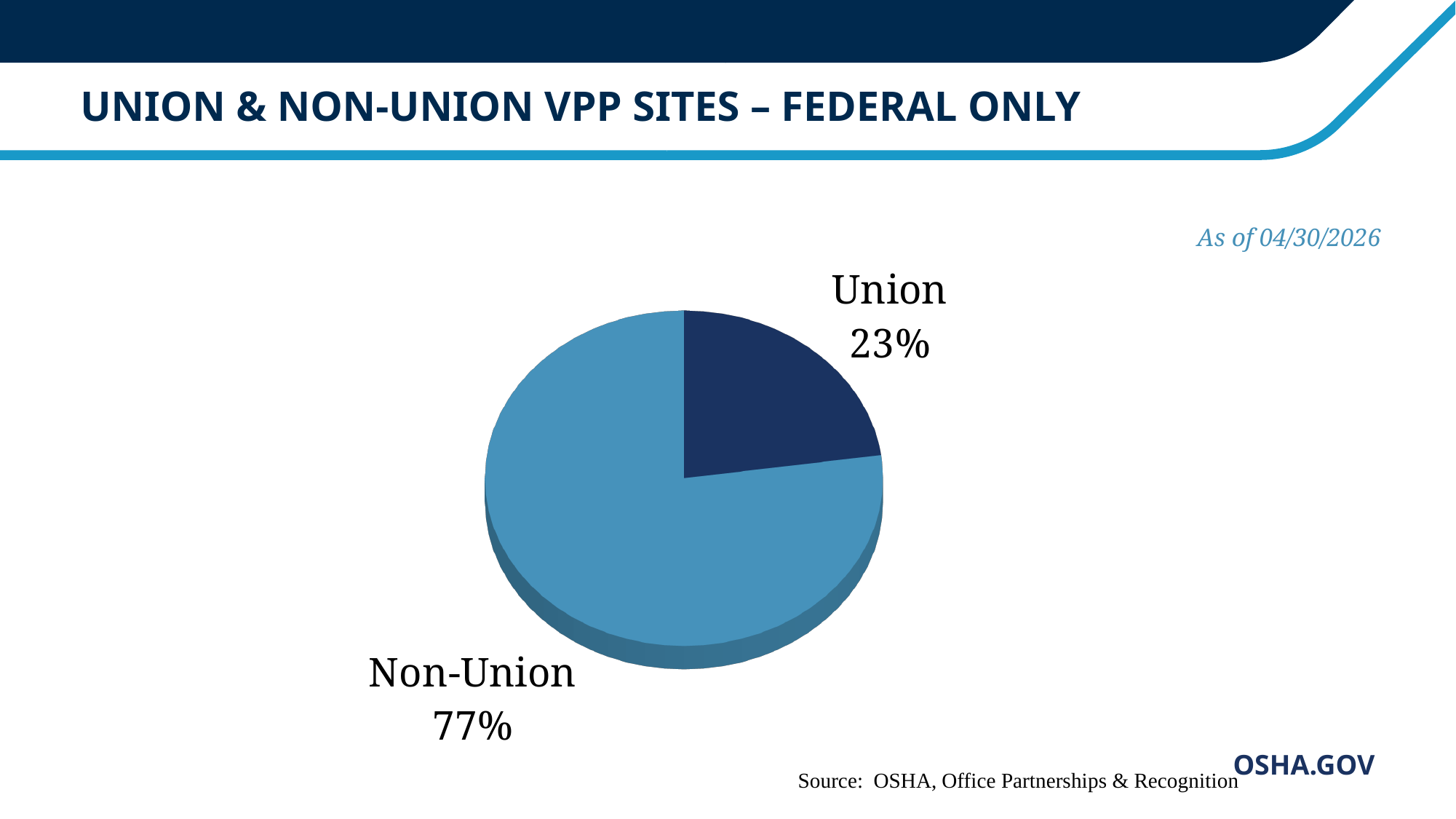
What share of the pie does the Union slice represent? 23% Which category has the largest share of the pie? Non-Union How many slices does the pie chart have? 2 What is the difference in percentage points between the Non-Union and Union shares? 54 What is the title of the chart on the slide? Union & Non-Union VPP Sites – Federal Only Which category has the smallest share of the pie? Union Which is larger, the Union share or the Non-Union share? Non-Union What percentage of federal VPP sites are Non-Union? 77% What colour is the Union slice of the pie? Dark navy blue What kind of chart is shown on the slide? Pie chart What percentage of federal VPP sites are Union? 23%